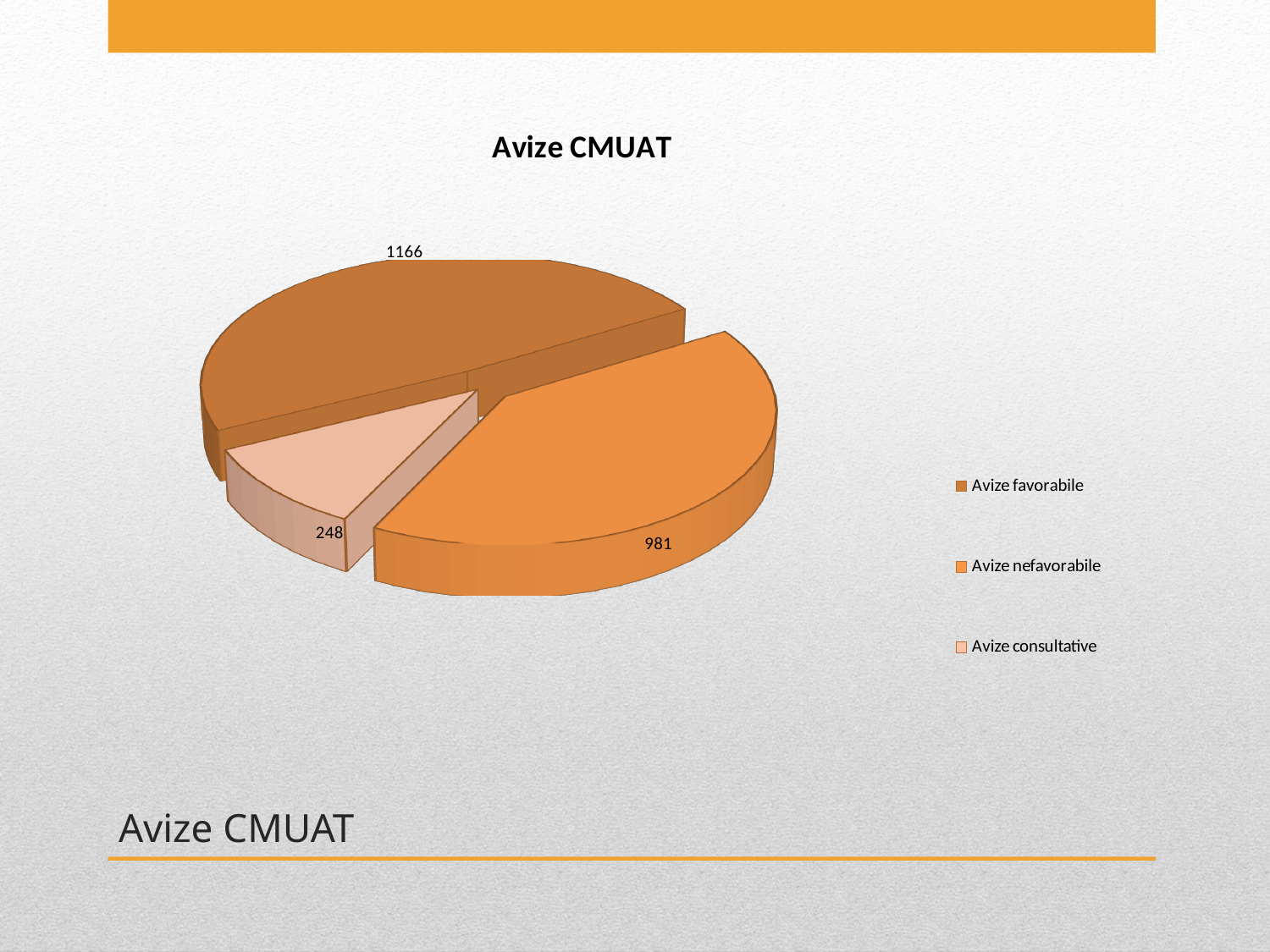
What is the value for Avize favorabile? 1166 What is the title of the chart? Avize CMUAT What is the total of all three slices in the pie chart? 2395 How many slices does the pie chart have? 3 What kind of chart is shown on the slide? Pie chart What is the difference between the values for Avize favorabile and Avize nefavorabile? 185 Which is larger, Avize nefavorabile or Avize consultative? Avize nefavorabile What is the value for Avize consultative? 248 Which category has the largest slice of the pie? Avize favorabile Which category has the smallest slice of the pie? Avize consultative What is the value for Avize nefavorabile? 981 What is the difference between the values for Avize nefavorabile and Avize consultative? 733